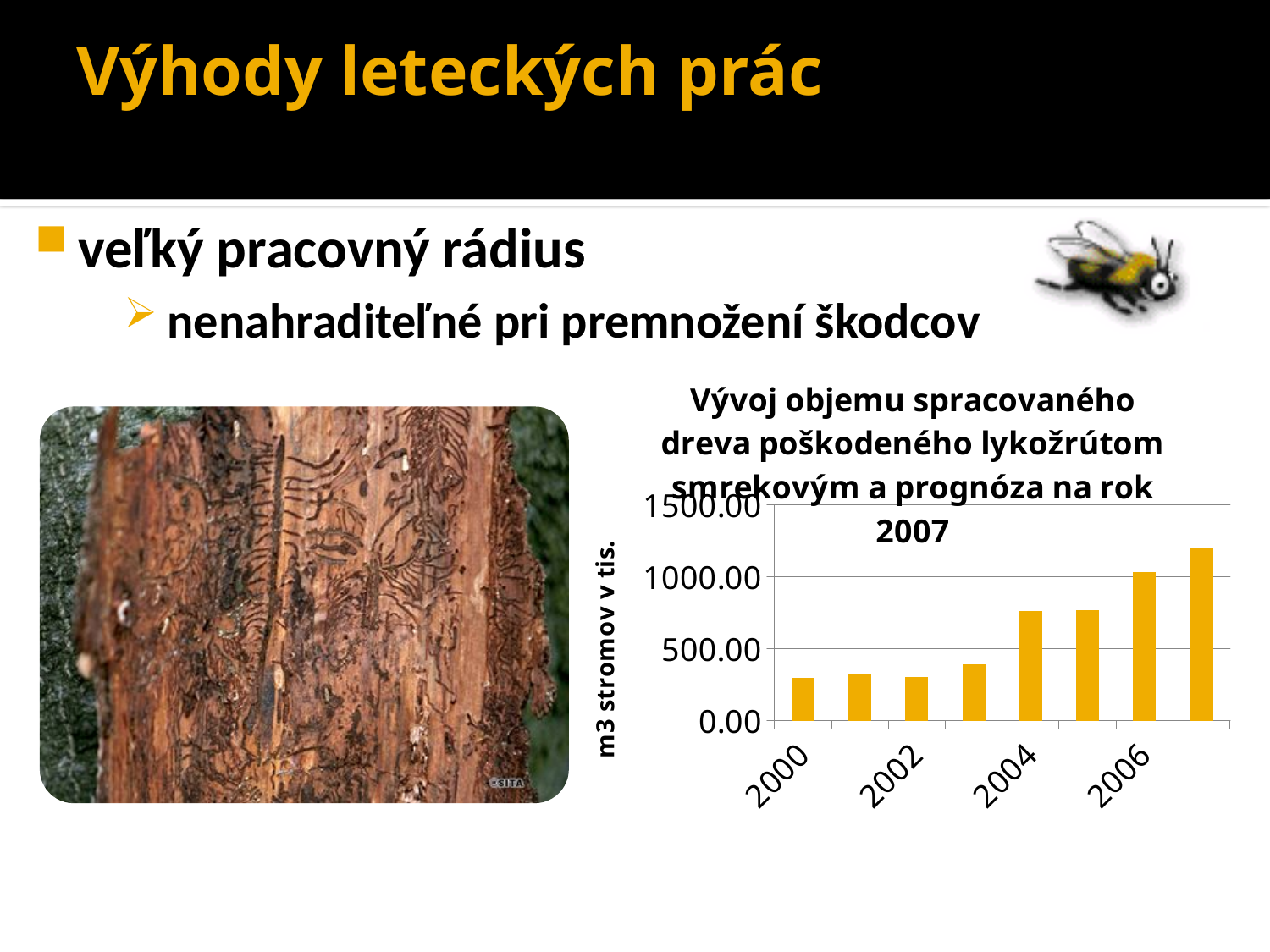
Is the value for 2004 greater or less than 500.00? greater Is the value for 2002 greater or less than 500.00? less What colour are the bars in the chart? orange Which has the larger value, 2002 or 2004? 2004 Do the values generally rise or fall from left to right along the x axis? rise Is the value for 2000 greater or less than 500.00? less What kind of chart is shown on the slide? bar chart What is the label on the vertical axis of the chart? m3 stromov v tis. Which has the larger value, 2004 or 2006? 2006 How many bars does the chart contain? 8